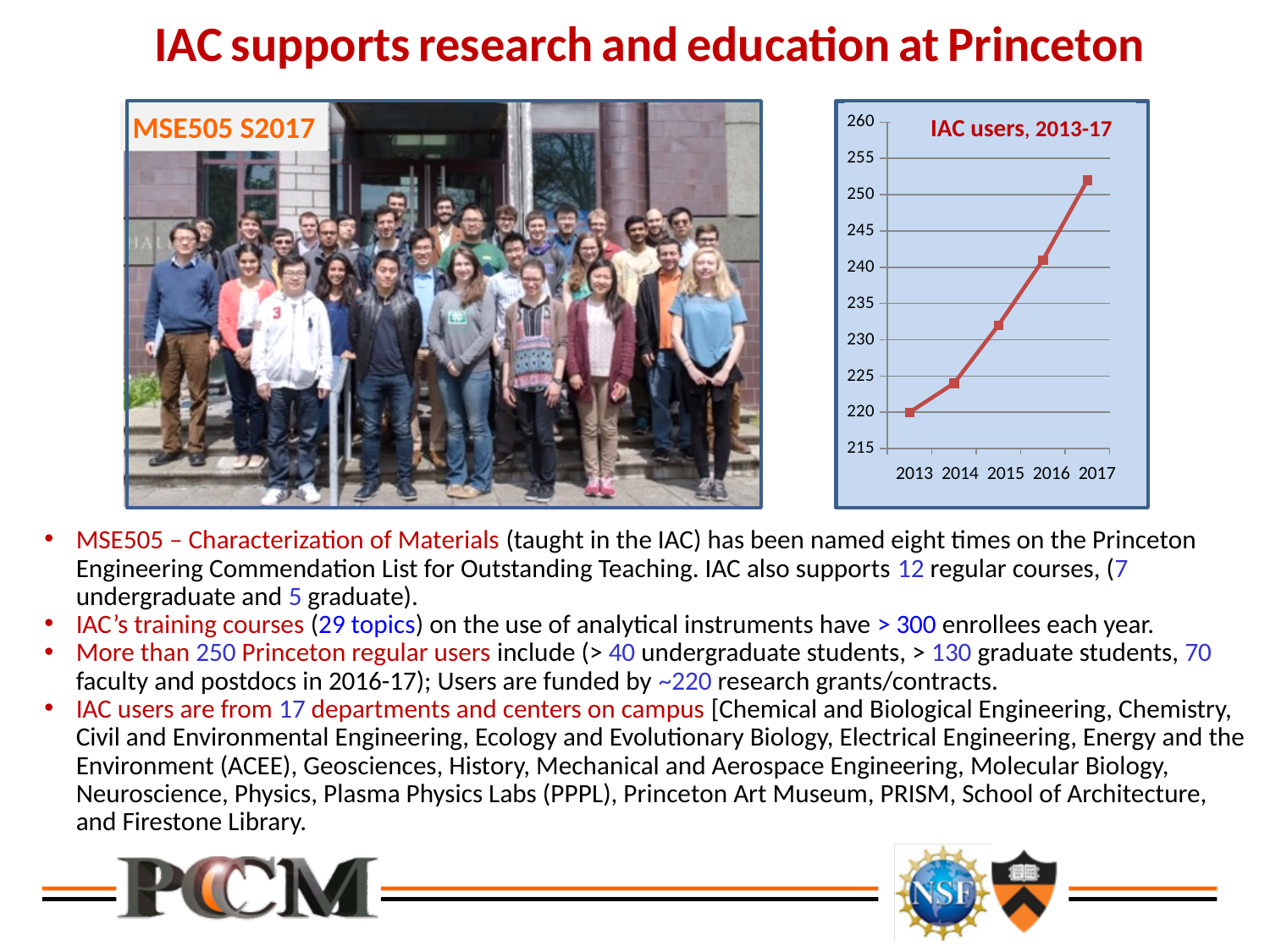
Which year has the highest number of IAC users in the chart? 2017 What is the title of the chart on the slide? IAC users, 2013-17 Is the value for 2017 greater or less than 250? greater Is the value for 2015 greater or less than 230? greater How many years are plotted on the x axis of the chart? 5 What kind of chart is shown on the slide? line chart Is the value for 2016 greater or less than 245? less Do the values in the chart rise or fall from 2013 to 2017? rise Which year has the lowest number of IAC users in the chart? 2013 Which year has more IAC users, 2014 or 2016? 2016 What is the number of IAC users for 2013 in the chart? 220